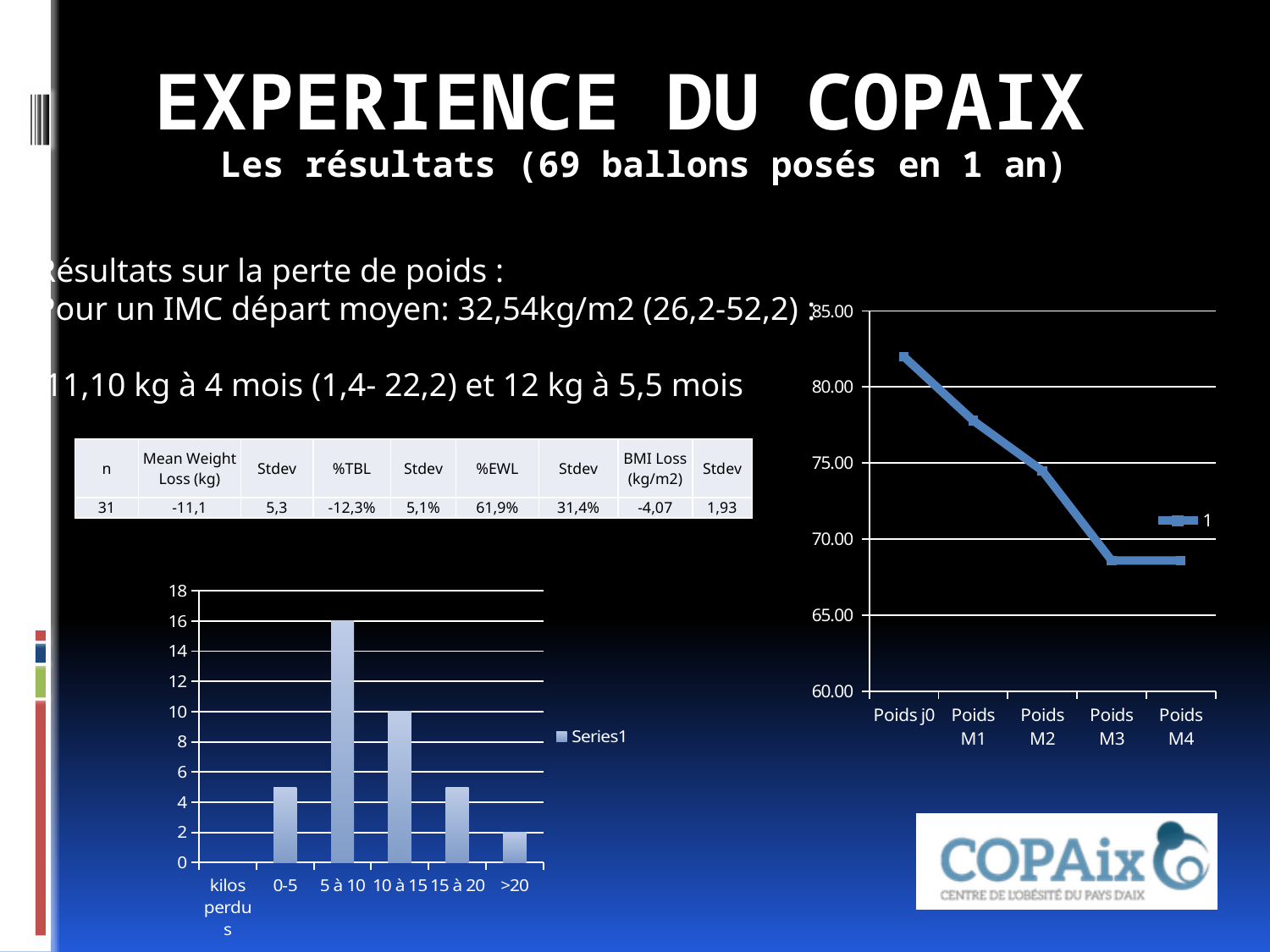
On the line chart on the right, how many points are plotted along the x axis? 5 On the bar chart at the bottom left, what series name does the legend show? Series1 On the bar chart at the bottom left, is the value for 0-5 greater or less than 4? greater What kind of chart is shown on the right side of the slide? line chart On the line chart on the right, do the values rise or fall from Poids j0 to Poids M4? fall On the bar chart at the bottom left, what is the value for the >20 category? 2 On the bar chart at the bottom left, which category has the lowest bar? >20 On the bar chart at the bottom left, what is the difference between the values for 5 à 10 and 10 à 15? 6 On the bar chart at the bottom left, what is the value for the 5 à 10 category? 16 On the line chart on the right, is the value for Poids M3 greater or less than 70.00? less On the bar chart at the bottom left, which category has the highest bar? 5 à 10 On the bar chart at the bottom left, what is the value for the 10 à 15 category? 10